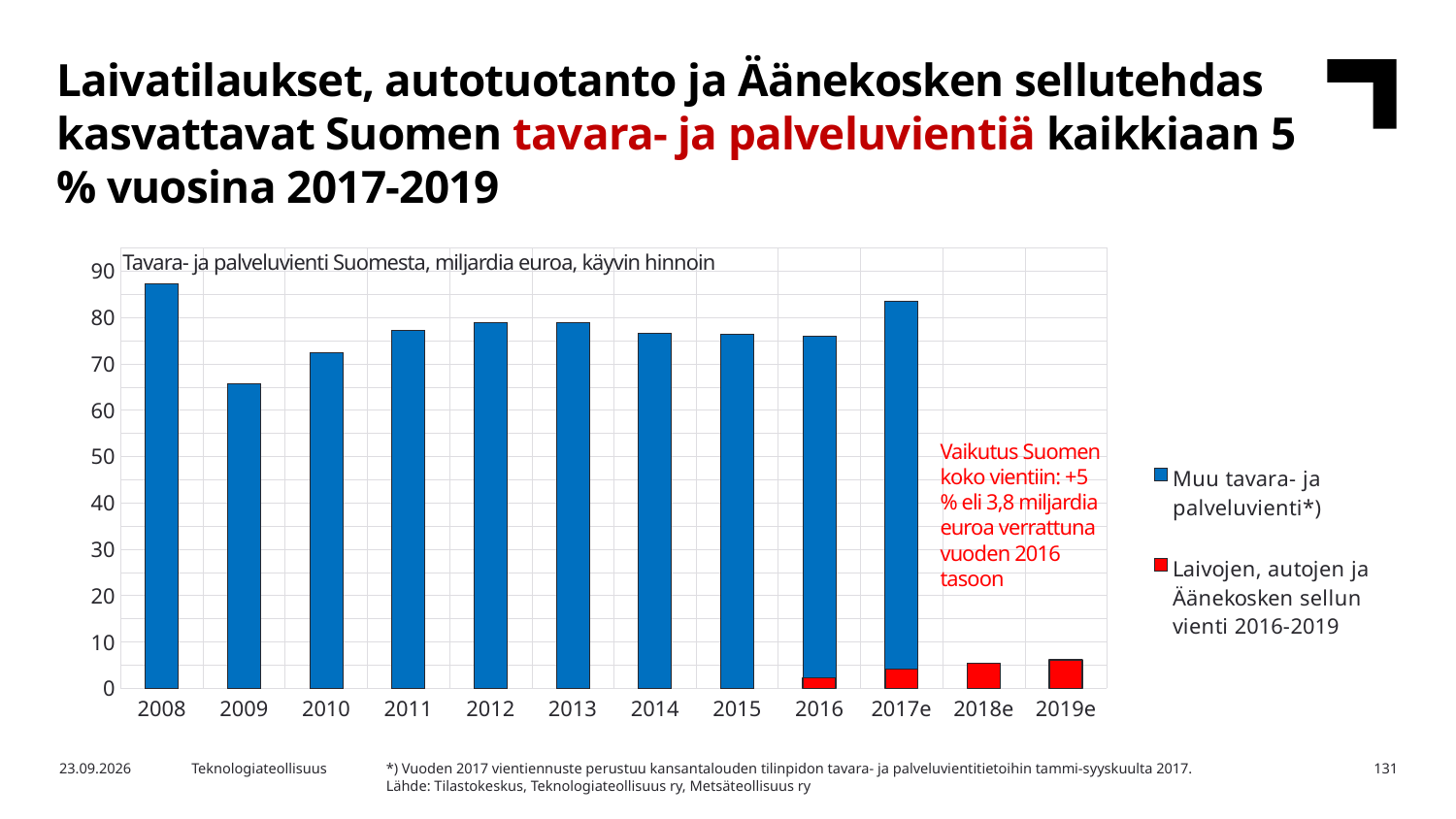
Is the value for 2009 greater or less than 70? less What is the title of the chart? Tavara- ja palveluvienti Suomesta, miljardia euroa, käyvin hinnoin Is the red 'Laivojen, autojen ja Äänekosken sellun vienti 2016-2019' value for 2018e greater or less than 10? less Which year has the lowest blue 'Muu tavara- ja palveluvienti*)' bar? 2009 Does the total value rise or fall from 2008 to 2009? fall What kind of chart is shown on the slide? Bar chart Which is larger, the total bar for 2008 or the total bar for 2009? 2008 Is the total value for 2008 greater or less than 80? greater How many series does the chart legend list? 2 How many years (categories) are shown on the x axis of the chart? 12 Which year has the highest total bar in the chart? 2008